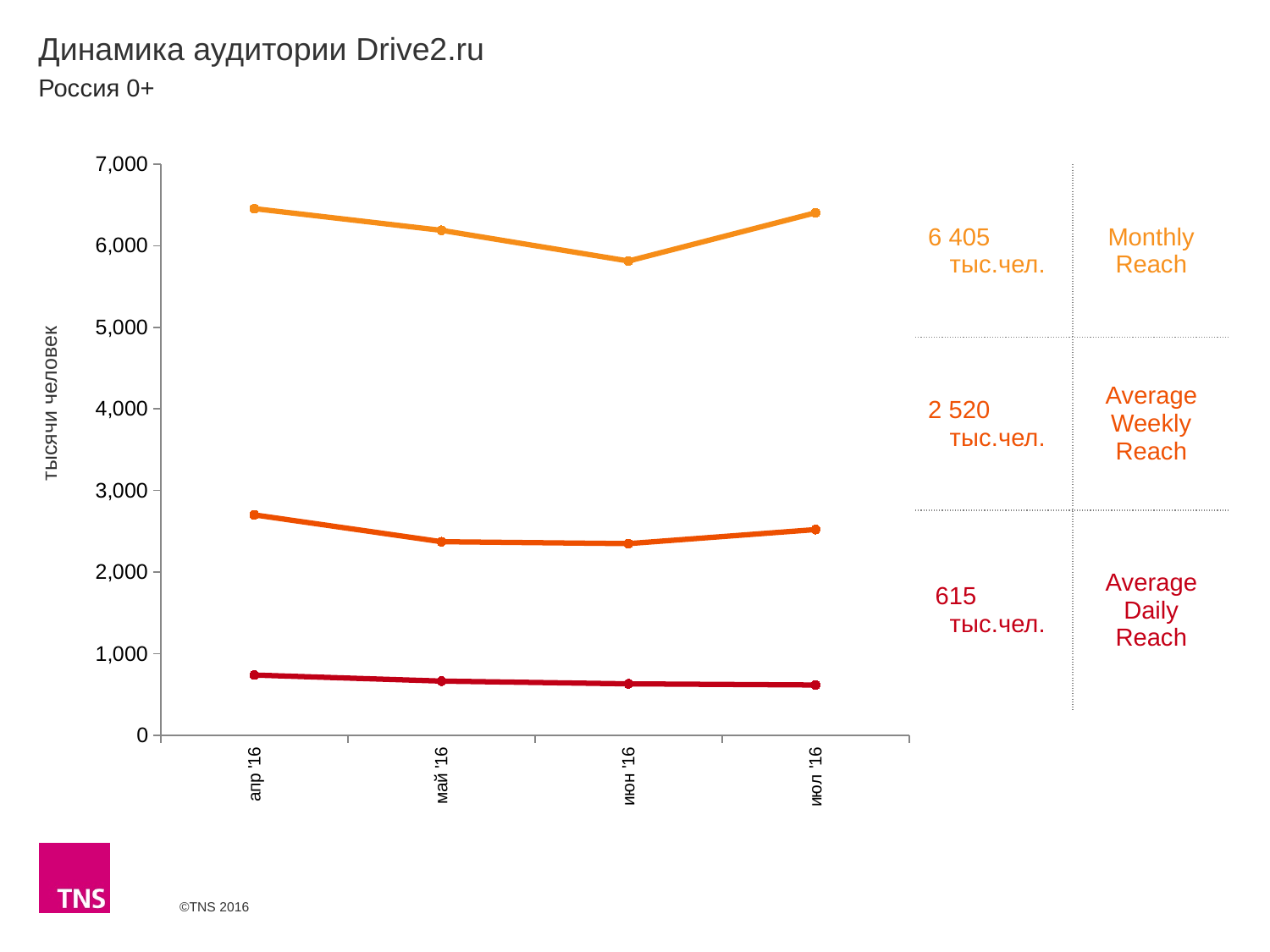
Is the Average Daily Reach value for апр '16 greater or less than 1,000? less What Average Weekly Reach value is printed on the slide? 2 520 тыс.чел. Is the Monthly Reach value for июн '16 greater or less than 6,000? less How many months are plotted along the x axis of the chart? 4 What is the title of the slide's chart? Динамика аудитории Drive2.ru What kind of chart is shown on the slide? line chart What Monthly Reach value is printed on the slide? 6 405 тыс.чел. In which month is the Monthly Reach line at its lowest? июн '16 What is the label of the vertical axis? тысячи человек Is the Monthly Reach value for апр '16 greater or less than 6,000? greater How many series (reach metrics) are plotted in the chart? 3 What Average Daily Reach value is printed on the slide? 615 тыс.чел.